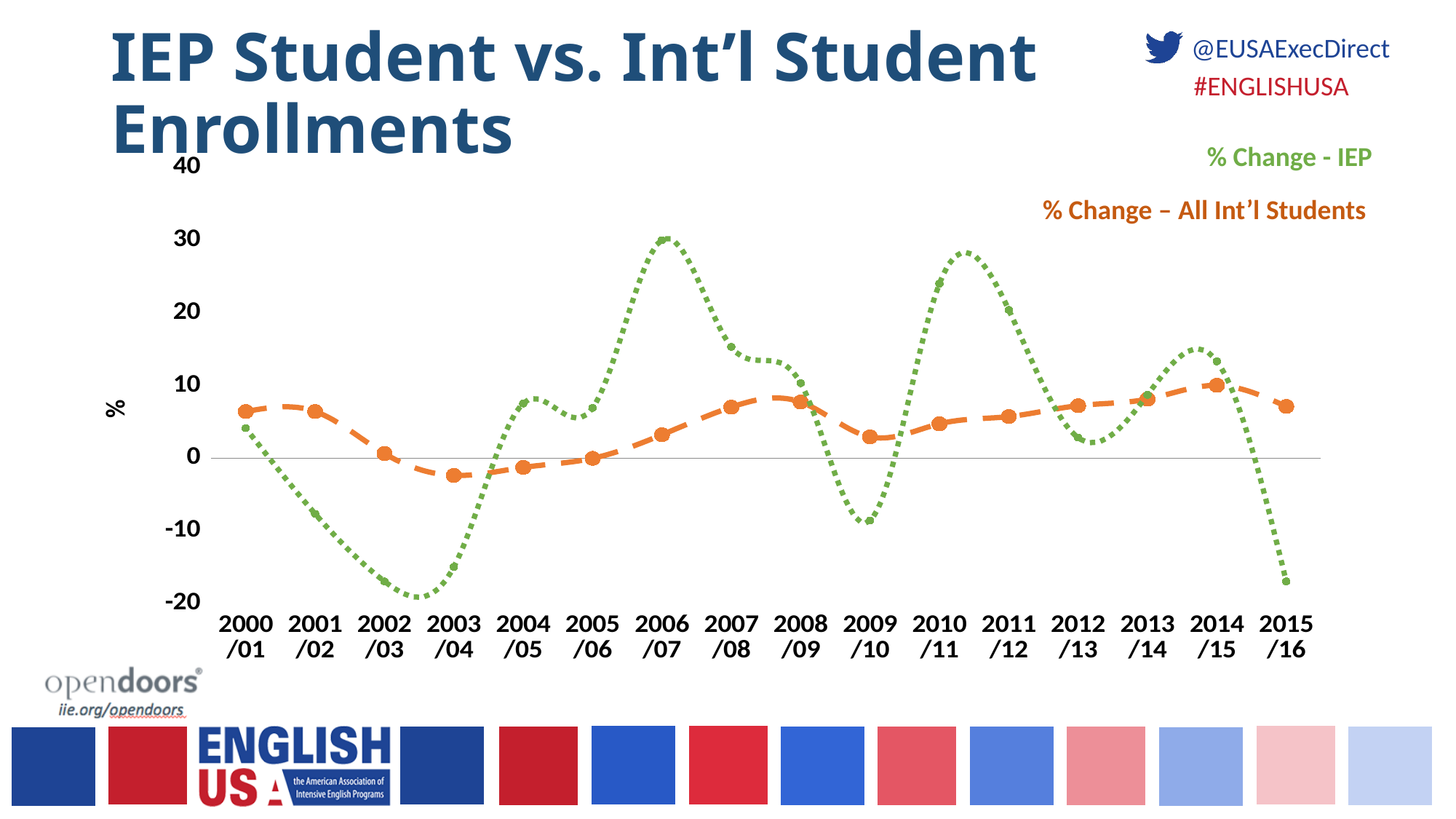
Does the % Change – All Int'l Students series rise or fall from 2003/04 to 2008/09? rise What kind of chart is shown on the slide? line chart Is the % Change - IEP value for 2002/03 greater or less than -10? less How many academic years are plotted along the x axis? 16 In which year does the % Change - IEP series reach its highest value? 2006/07 How many series does the legend list? 2 What colour is the % Change - IEP line? green In 2009/10, which series has the larger value: % Change - IEP or % Change – All Int'l Students? % Change – All Int'l Students In which year does the % Change – All Int'l Students series reach its lowest value? 2003/04 Is the % Change - IEP value for 2009/10 greater or less than 0? less In which year does the % Change – All Int'l Students series reach its highest value? 2014/15 Is the % Change - IEP value for 2006/07 greater or less than 20? greater